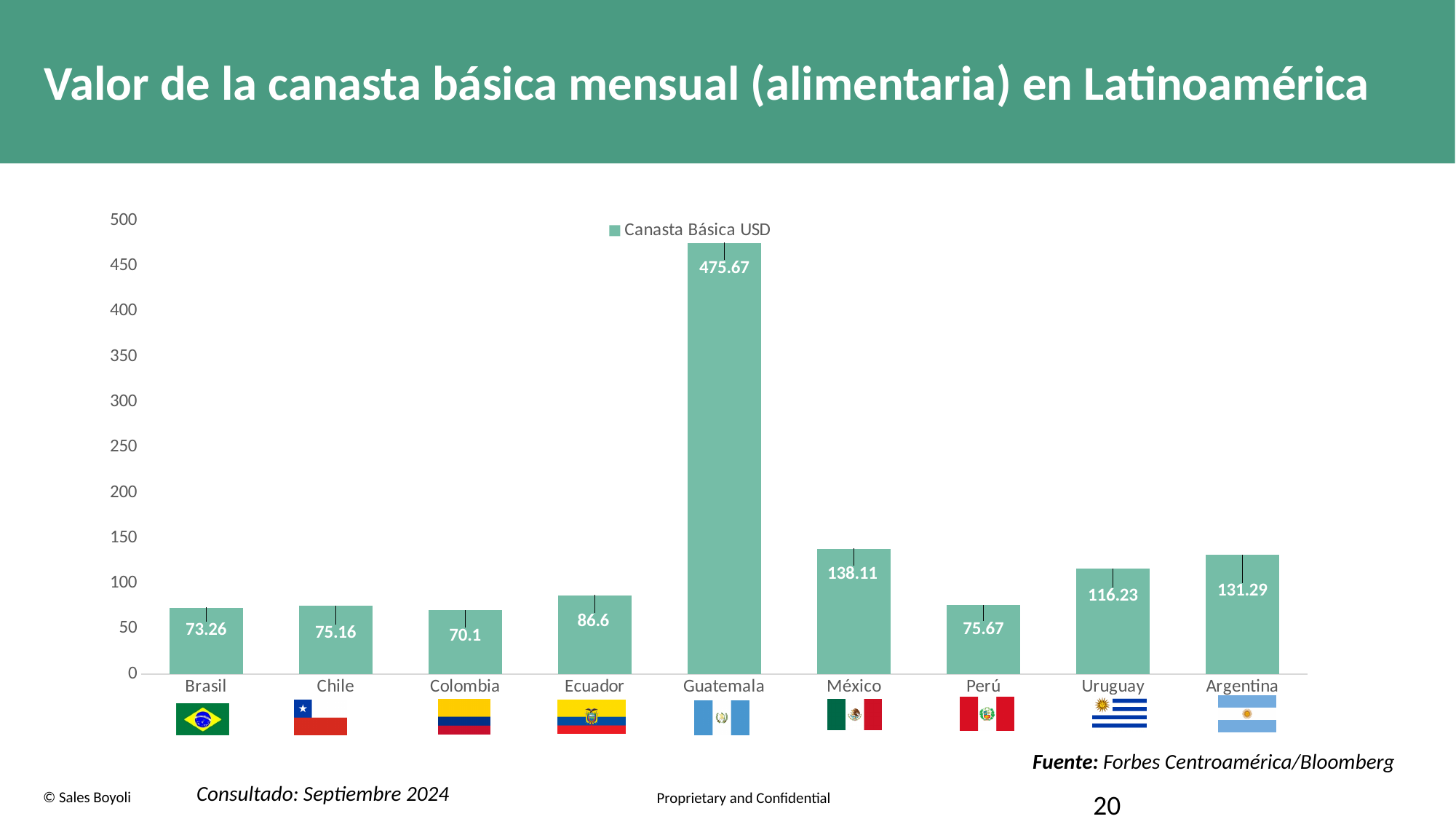
Which is larger, the value for Ecuador or the value for Perú? Ecuador Which country has the lowest value? Colombia What kind of chart is shown on the slide? bar chart Which country has the highest value? Guatemala What is the value for México? 138.11 How many countries are shown on the x axis? 9 What is the legend entry for the series shown? Canasta Básica USD What is the value for Guatemala? 475.67 Is the value for Argentina greater or less than 100? greater What is the difference between the values for Guatemala and México? 337.56 What is the difference between the values for Argentina and Uruguay? 15.06 What is the value for Colombia? 70.1